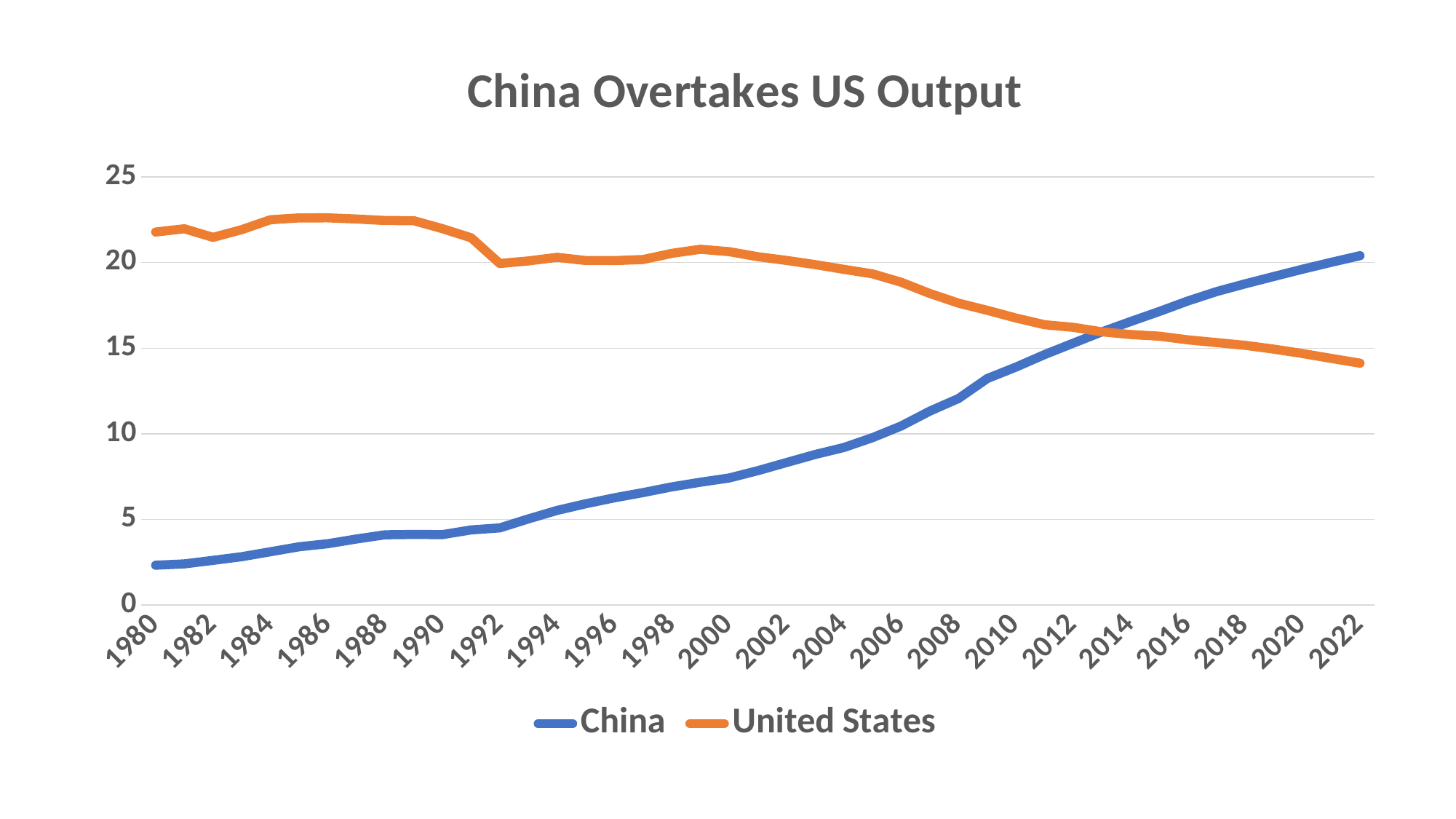
Is the value for the United States in 1980 greater or less than 20? greater Is the value for China in 1980 greater or less than 5? less Does the China line rise or fall from 1980 to 2022? rise How many series does the legend list? 2 Is the value for China in 2010 greater or less than 10? greater In 1980, which series has the larger value, China or the United States? United States Does the United States line rise or fall from 2000 to 2022? fall Which series is drawn in orange? United States In 2022, which series has the larger value, China or the United States? China What kind of chart is shown on the slide? line chart What is the title of the chart? China Overtakes US Output